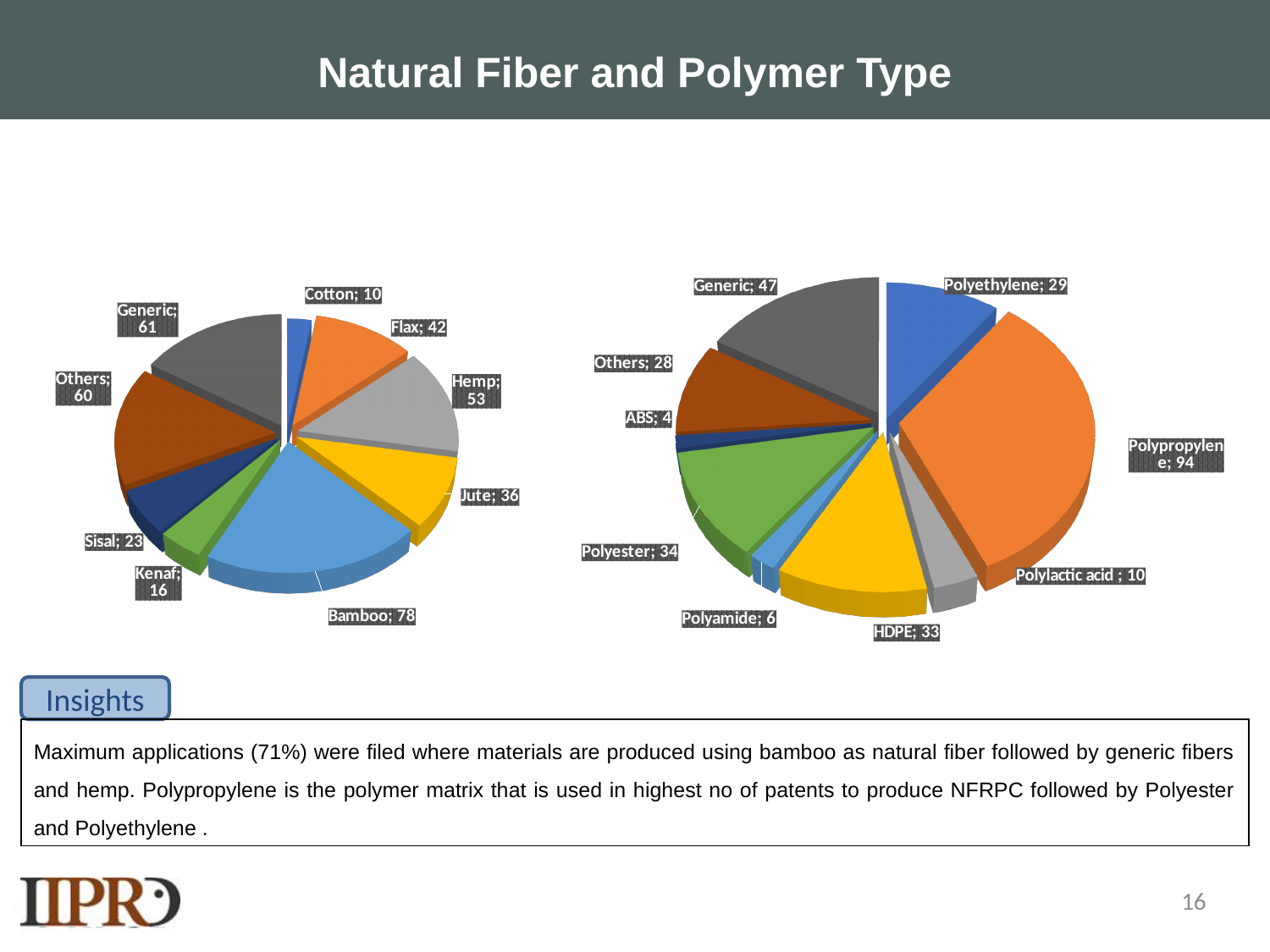
On the right pie chart, what is the value for HDPE? 33 On the left pie chart, which is larger, Flax or Jute? Flax On the right pie chart, which category has the smallest value? ABS On the left pie chart, what is the difference between Generic and Others? 1 What kind of chart is the right chart? Pie chart On the left pie chart, what is the value for Bamboo? 78 How many slices does the left pie chart have? 9 On the left pie chart, which category has the smallest value? Cotton On the left pie chart, which category has the largest value? Bamboo On the right pie chart, what is the difference between Polypropylene and Polyester? 60 On the right pie chart, what is the value for Polypropylene? 94 On the left pie chart, what is the value for Hemp? 53